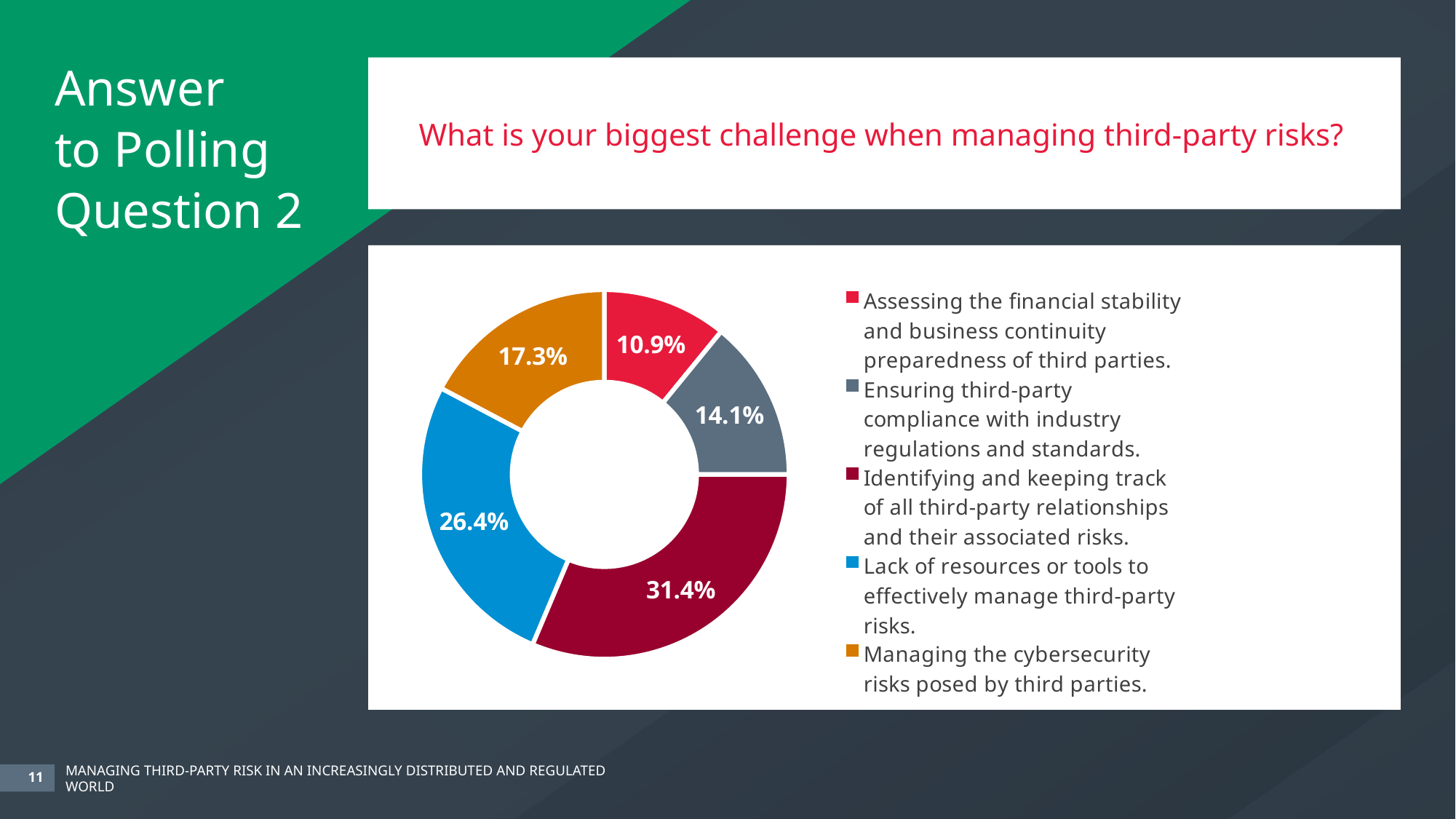
What colour is the slice for "Managing the cybersecurity risks posed by third parties"? Orange How many entries does the legend list? 5 Which challenge received the largest share of responses? Identifying and keeping track of all third-party relationships and their associated risks. What is the polling question shown above the chart? What is your biggest challenge when managing third-party risks? Which challenge received the smallest share of responses? Assessing the financial stability and business continuity preparedness of third parties. What share of respondents chose "Managing the cybersecurity risks posed by third parties"? 17.3% What kind of chart is shown on the slide? Pie chart (donut) How many slices does the pie chart have? 5 Which received a larger share: "Lack of resources or tools" or "Managing the cybersecurity risks"? Lack of resources or tools to effectively manage third-party risks. What share of respondents chose "Ensuring third-party compliance with industry regulations and standards"? 14.1% What share of respondents chose "Lack of resources or tools to effectively manage third-party risks"? 26.4% What is the difference in percentage points between the largest slice (31.4%) and the smallest slice (10.9%)? 20.5